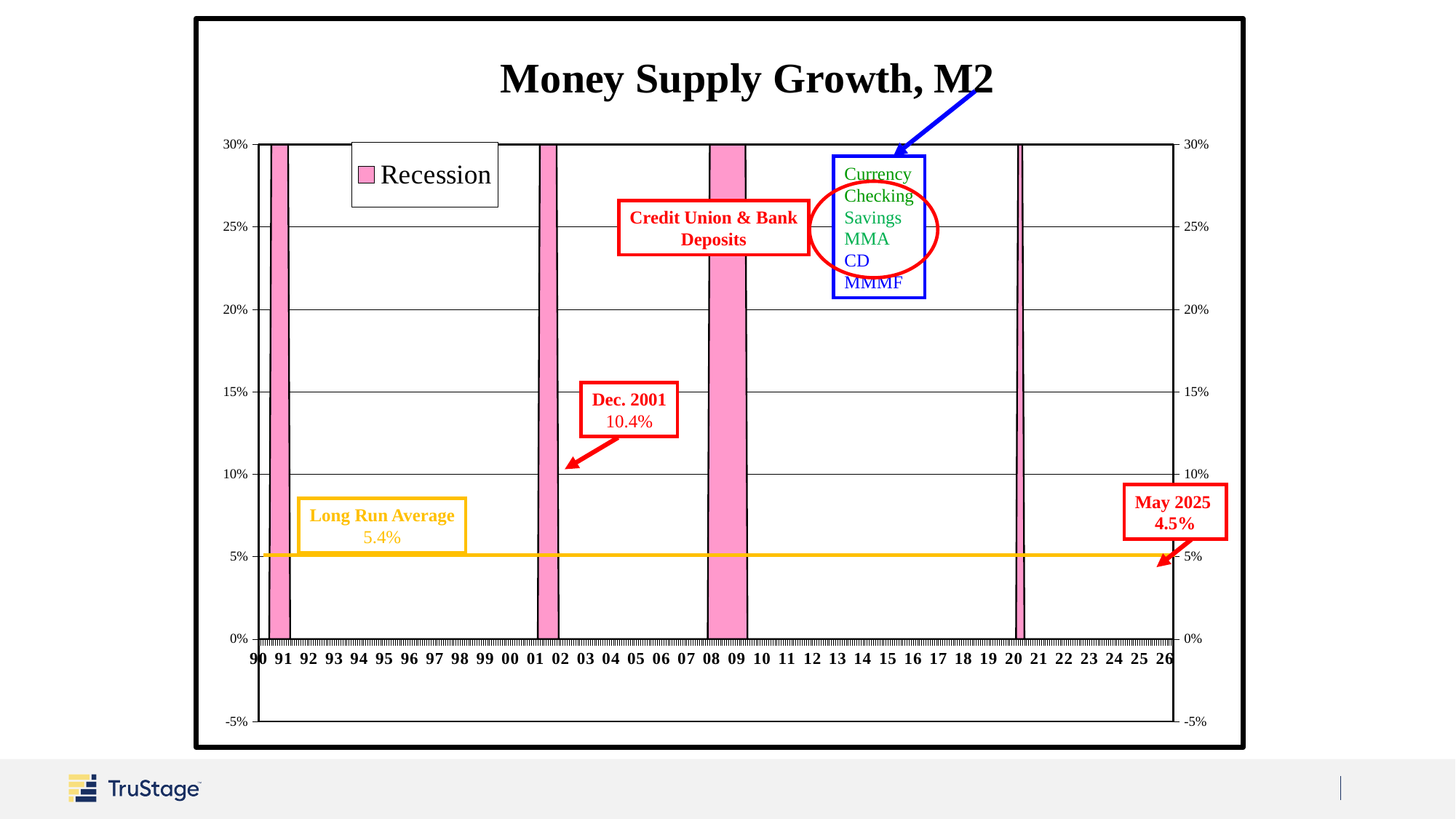
What is the title of the chart? Money Supply Growth, M2 How many entries does the chart legend list? 1 Is the annotated May 2025 value greater or less than 5%? less What is the difference between the annotated Dec. 2001 value and the annotated May 2025 value? 5.9% How many M2 components are listed in the blue box on the chart? 6 What M2 growth value is annotated for May 2025? 4.5% What M2 growth value is annotated for Dec. 2001? 10.4% Is the annotated Dec. 2001 value greater or less than 10%? greater What is the Long Run Average value shown on the chart? 5.4% Which is larger, the annotated Dec. 2001 value or the annotated May 2025 value? Dec. 2001 How many shaded recession periods are shown on the chart? 4 Is the annotated May 2025 value greater or less than the Long Run Average of 5.4%? less